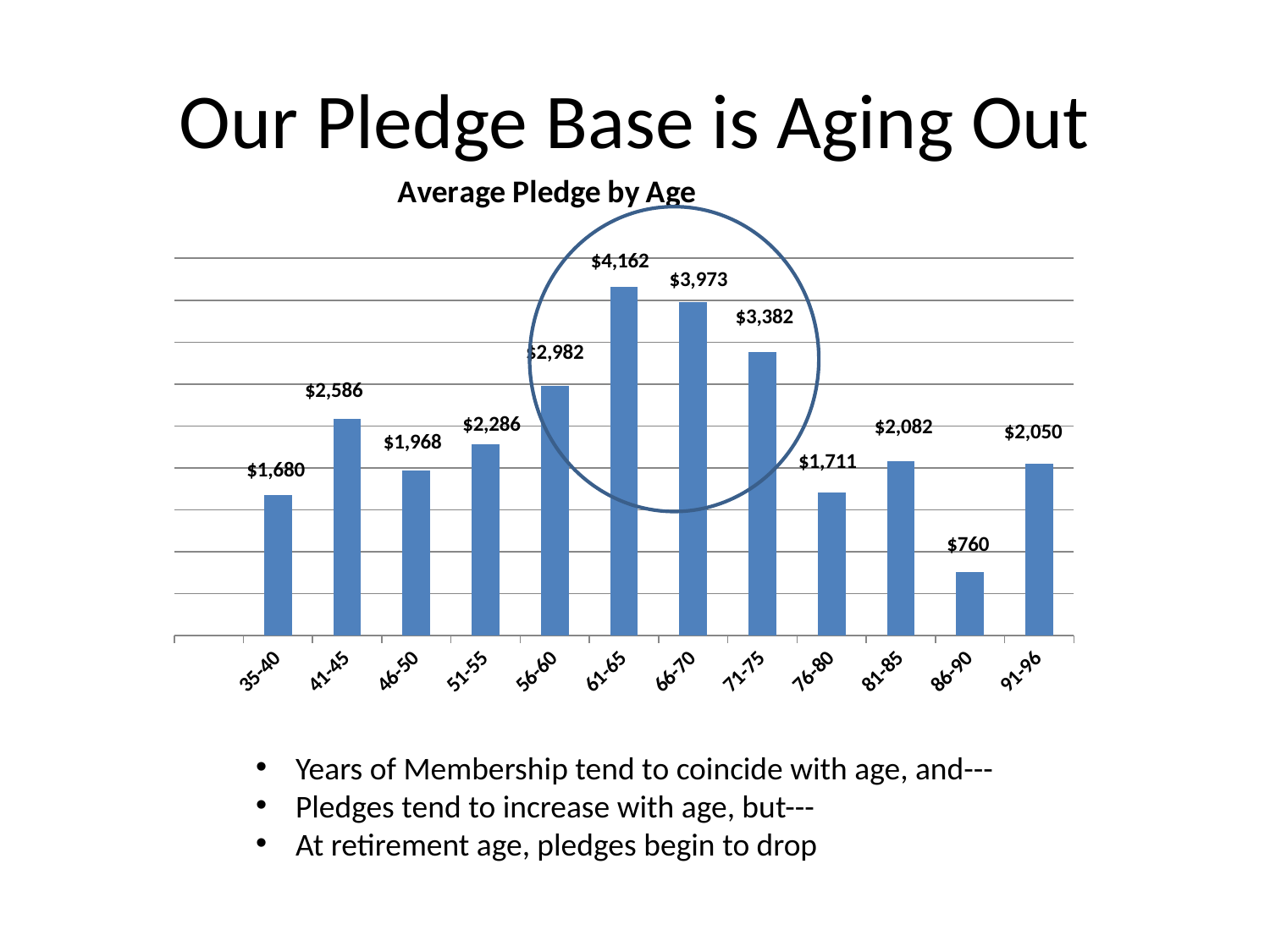
What kind of chart is shown on the slide? Bar chart What is the average pledge for the 61-65 age group? $4,162 Which age group has the lowest average pledge? 86-90 What is the title of the chart? Average Pledge by Age What is the average pledge for the 86-90 age group? $760 What is the average pledge for the 35-40 age group? $1,680 Which has a larger average pledge, the 81-85 group or the 91-96 group? 81-85 Which has a larger average pledge, the 51-55 group or the 76-80 group? 51-55 What is the difference between the average pledge for 61-65 and for 66-70? $189 Which age group has the highest average pledge? 61-65 How many age groups are shown on the chart? 12 What is the difference between the average pledge for 41-45 and for 46-50? $618